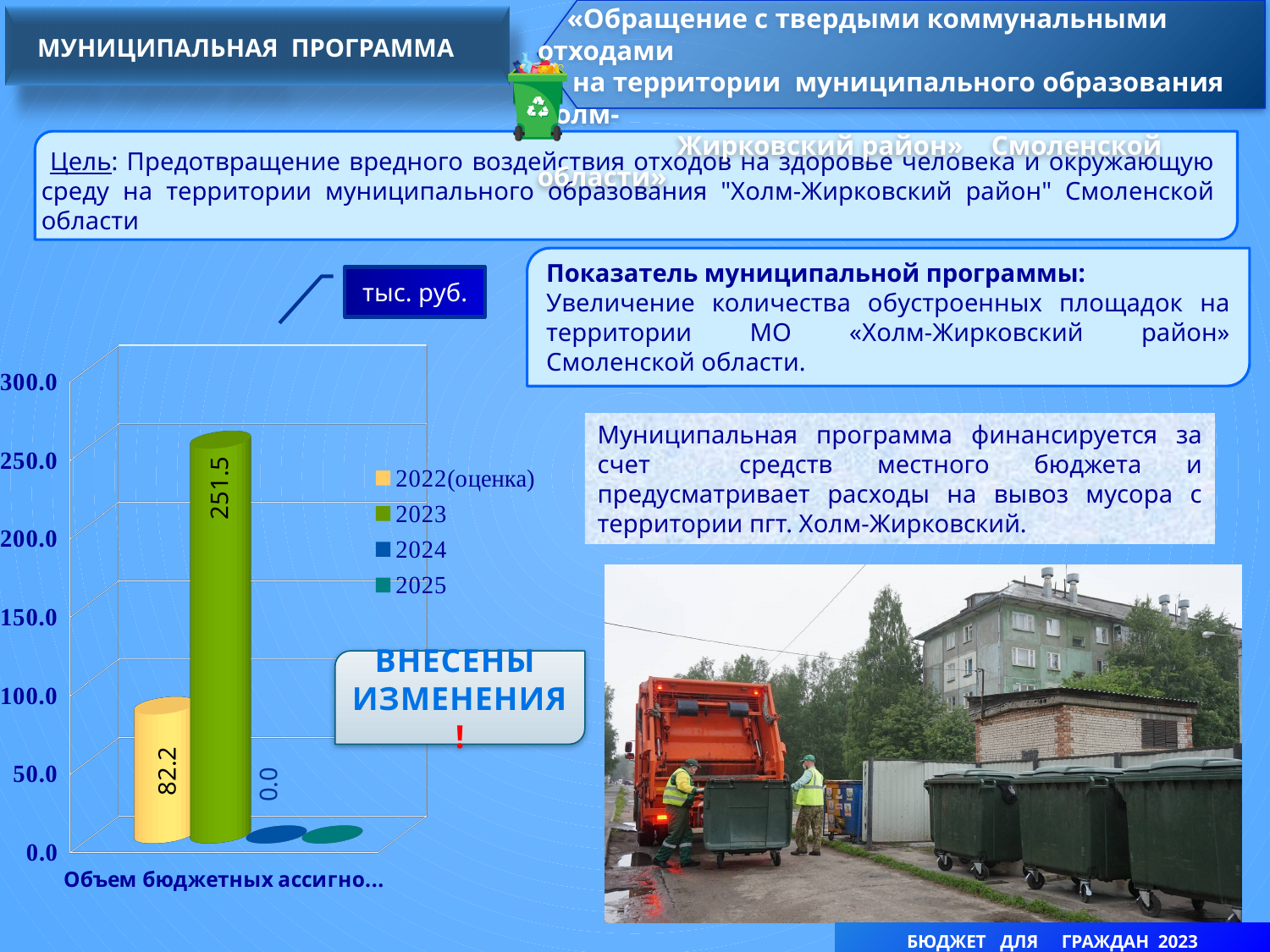
Which is larger in the bar chart: the value for 2022(оценка) or the value for 2023? 2023 Is the value for 2025 greater or less than 50.0? less What is the value for the 2024 series in the bar chart? 0.0 What unit is indicated for the values in the bar chart? тыс. руб. What kind of chart is shown on the slide? bar chart What is the value for the 2023 series in the bar chart? 251.5 Which series has the highest value in the bar chart? 2023 What is the value for the 2022(оценка) series in the bar chart? 82.2 Is the value for 2022(оценка) greater or less than 100.0? less Is the value for 2023 greater or less than 200.0? greater How many series does the legend of the bar chart list? 4 What is the difference between the 2023 value and the 2022(оценка) value in the bar chart? 169.3